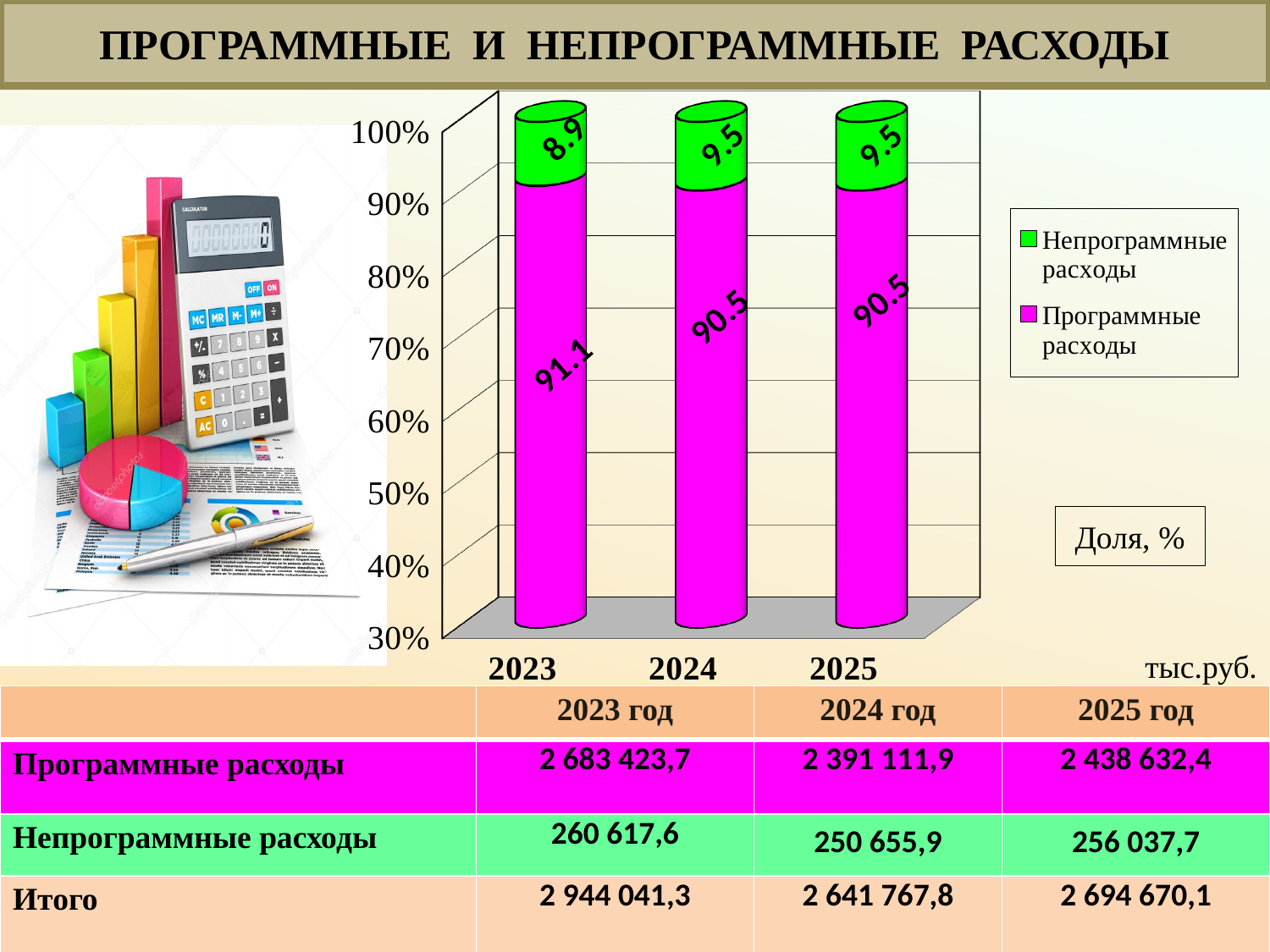
What is the share of Программные расходы for 2025 in the chart? 90.5 What is the share of Непрограммные расходы for 2023 in the chart? 8.9 In which year is the share of Непрограммные расходы lowest in the chart? 2023 What is the difference between the share of Программные расходы in 2023 and in 2024? 0.6 How many years are shown on the x axis of the chart? 3 What is the share of Программные расходы for 2023 in the chart? 91.1 What is the share of Непрограммные расходы for 2024 in the chart? 9.5 How many series does the chart legend list? 2 Which colour represents Непрограммные расходы in the chart? Green What kind of chart is shown on the slide? Stacked bar chart Which is larger in the chart: the share of Непрограммные расходы in 2023 or in 2025? 2025 In which year is the share of Программные расходы highest in the chart? 2023